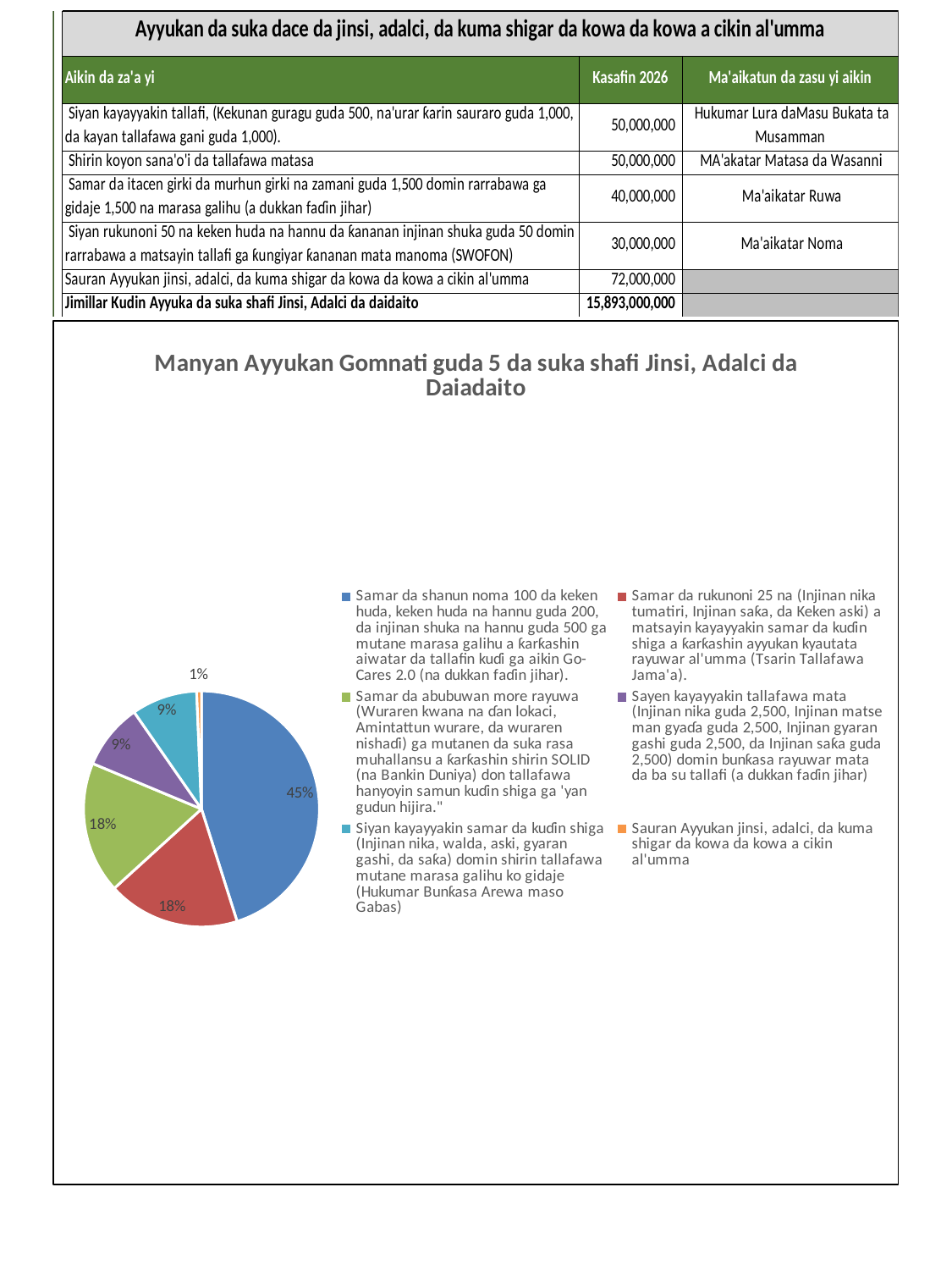
How many entries does the pie chart's legend list? 6 What share of the pie does the slice for 'Sayen kayayyakin tallafawa mata' represent? 9% What share of the pie does the slice for 'Samar da rukunoni 25 na (Injinan nika tumatiri, Injinan saka, da Keken aski)' represent? 18% What is the difference in percentage points between the largest slice (45%) and the 'Samar da abubuwan more rayuwa' slice (18%)? 27 What kind of chart is shown on the slide? pie chart Which is larger: the 'Siyan kayayyakin samar da kuɗin shiga' slice or the 'Samar da abubuwan more rayuwa' slice? Samar da abubuwan more rayuwa Which legend entry corresponds to the smallest slice of the pie chart? Sauran Ayyukan jinsi, adalci, da kuma shigar da kowa da kowa a cikin al'umma What share of the pie does the slice for 'Sauran Ayyukan jinsi, adalci, da kuma shigar da kowa da kowa a cikin al'umma' represent? 1% What is the title of the pie chart? Manyan Ayyukan Gomnati guda 5 da suka shafi Jinsi, Adalci da Daiadaito How many slices does the pie chart have? 6